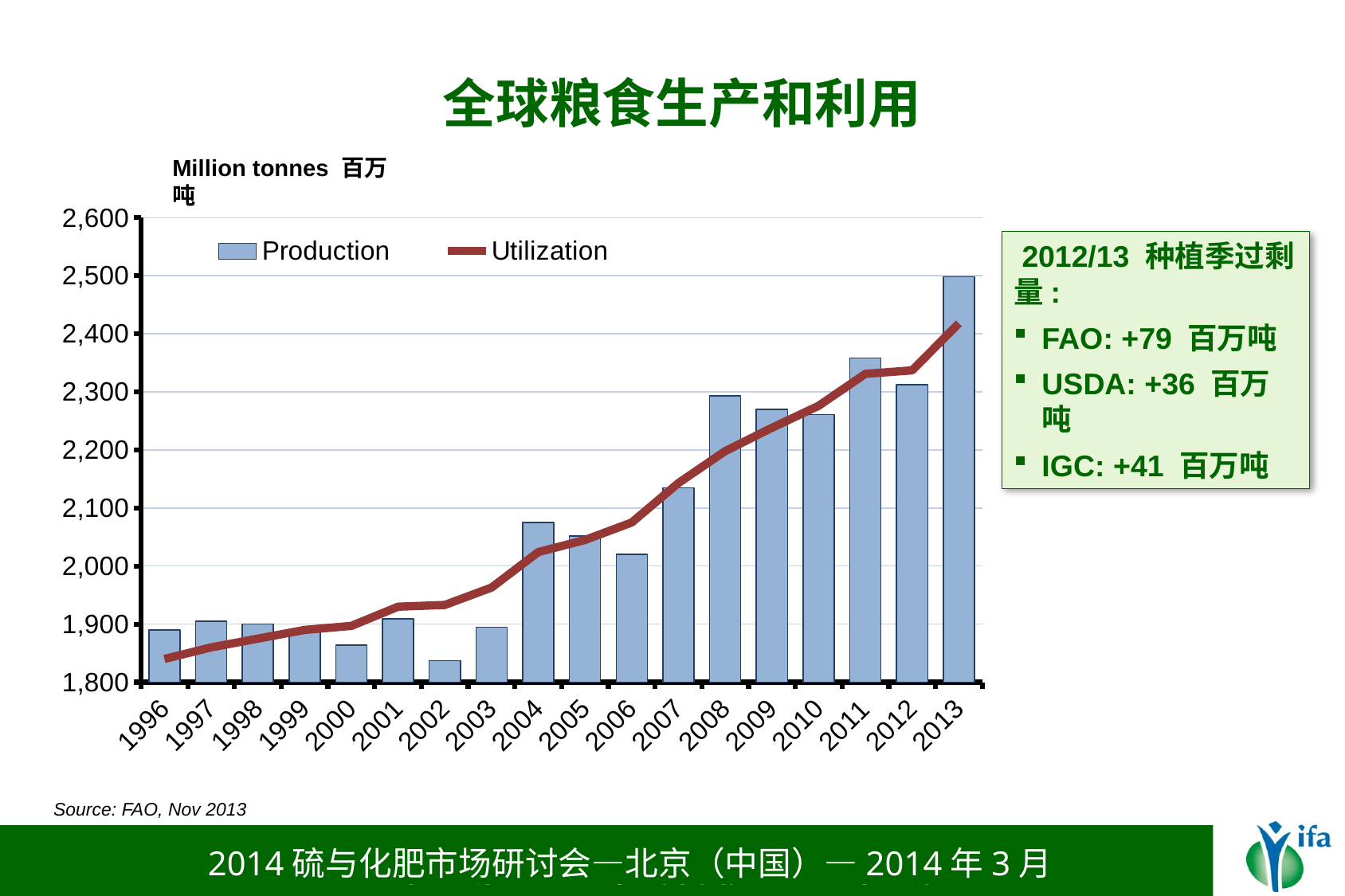
What unit is given for the chart's y axis? Million tonnes Does the Utilization line generally rise or fall from 1996 to 2013? rise What kind of chart is shown on the slide? A bar chart with a line series Is the Production value for 2013 greater or less than 2,400? greater Is the Production value for 2002 greater or less than 1,900? less Which year has the larger Production bar, 2008 or 2010? 2008 What are the two series named in the chart legend? Production and Utilization Is the Utilization value for 2013 greater or less than 2,400? greater How many years are shown along the x axis of the chart? 18 Which year has the highest Production bar? 2013 Which year has the lowest Production bar? 2002 How many series does the chart legend list? 2